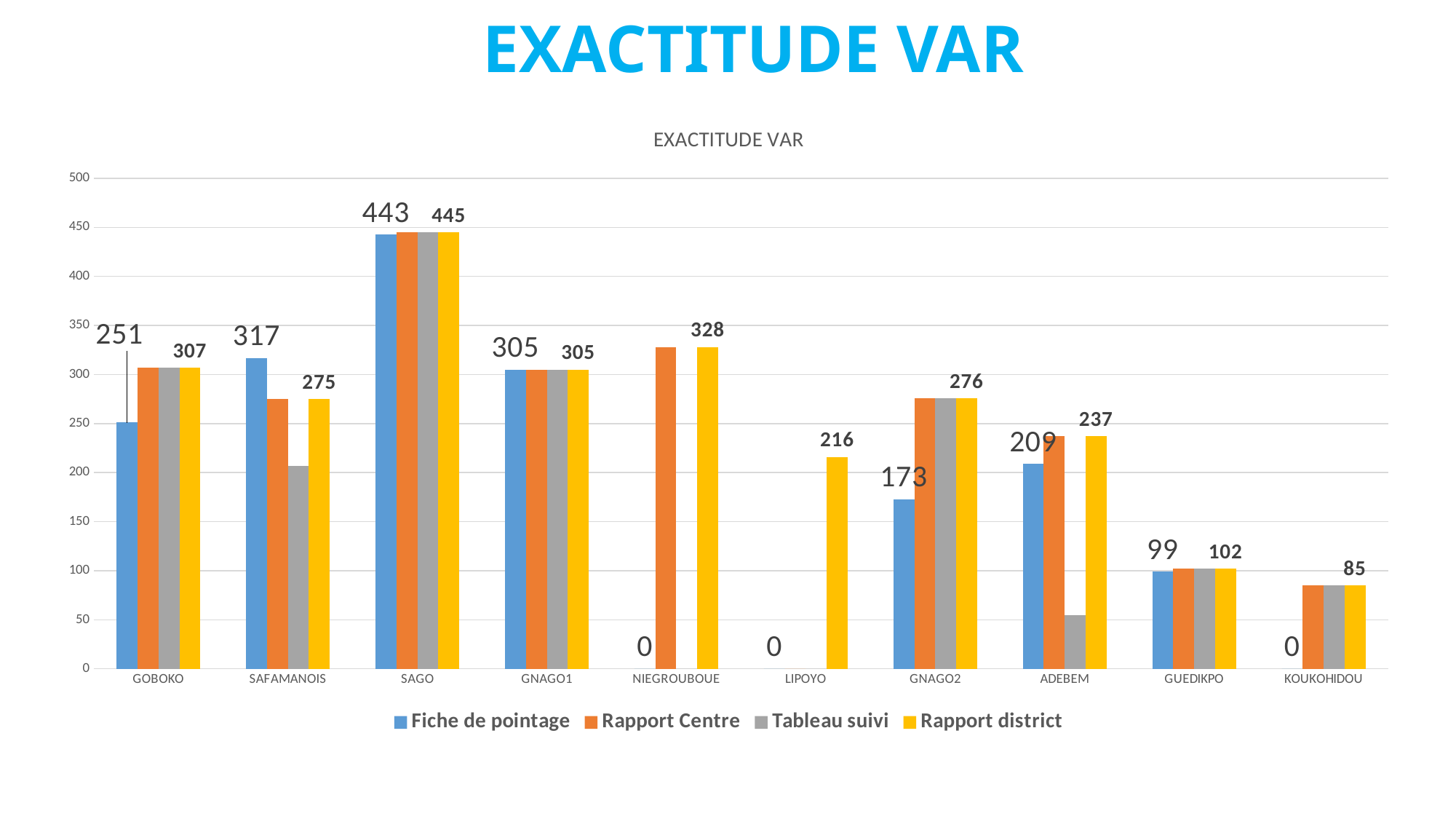
What is the difference between the Rapport district value and the Fiche de pointage value for GOBOKO? 56 What is the Rapport district value for LIPOYO? 216 What is the Fiche de pointage value for GOBOKO? 251 For SAFAMANOIS, which is larger: the Fiche de pointage value or the Rapport district value? Fiche de pointage How many categories are shown on the x axis? 10 What kind of chart is shown on the slide? bar chart What is the Rapport district value for SAGO? 445 What is the Fiche de pointage value for NIEGROUBOUE? 0 Which category has the lowest Rapport district value? KOUKOHIDOU Which category has the highest Fiche de pointage value? SAGO Is the Tableau suivi value for ADEBEM greater or less than 100? less How many series does the legend list? 4